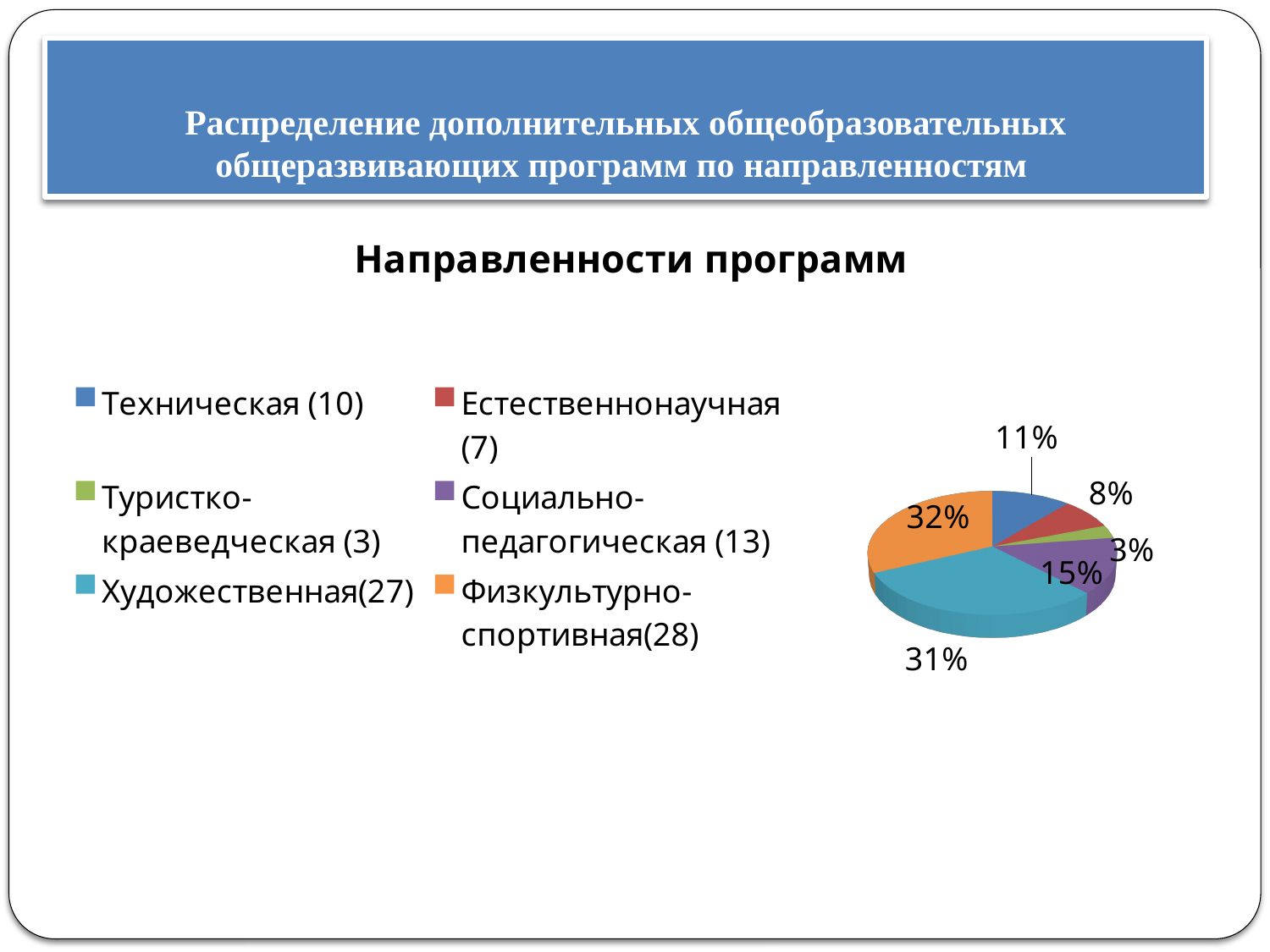
How many categories does the legend list? 6 Which has a larger share, Техническая or Социально-педагогическая? Социально-педагогическая What percentage share does the Техническая slice have? 11% What kind of chart is shown on the slide? pie chart How many programs does the legend give for Естественнонаучная? 7 What is the chart's title? Направленности программ What is the difference in percentage points between the Художественная and Естественнонаучная slices? 23% Which category has the largest share of the pie? Физкультурно-спортивная Which category has the smallest share of the pie? Туристко-краеведческая How many programs does the legend give for Художественная? 27 What percentage share does the Туристко-краеведческая slice have? 3% What percentage share does the Социально-педагогическая slice have? 15%